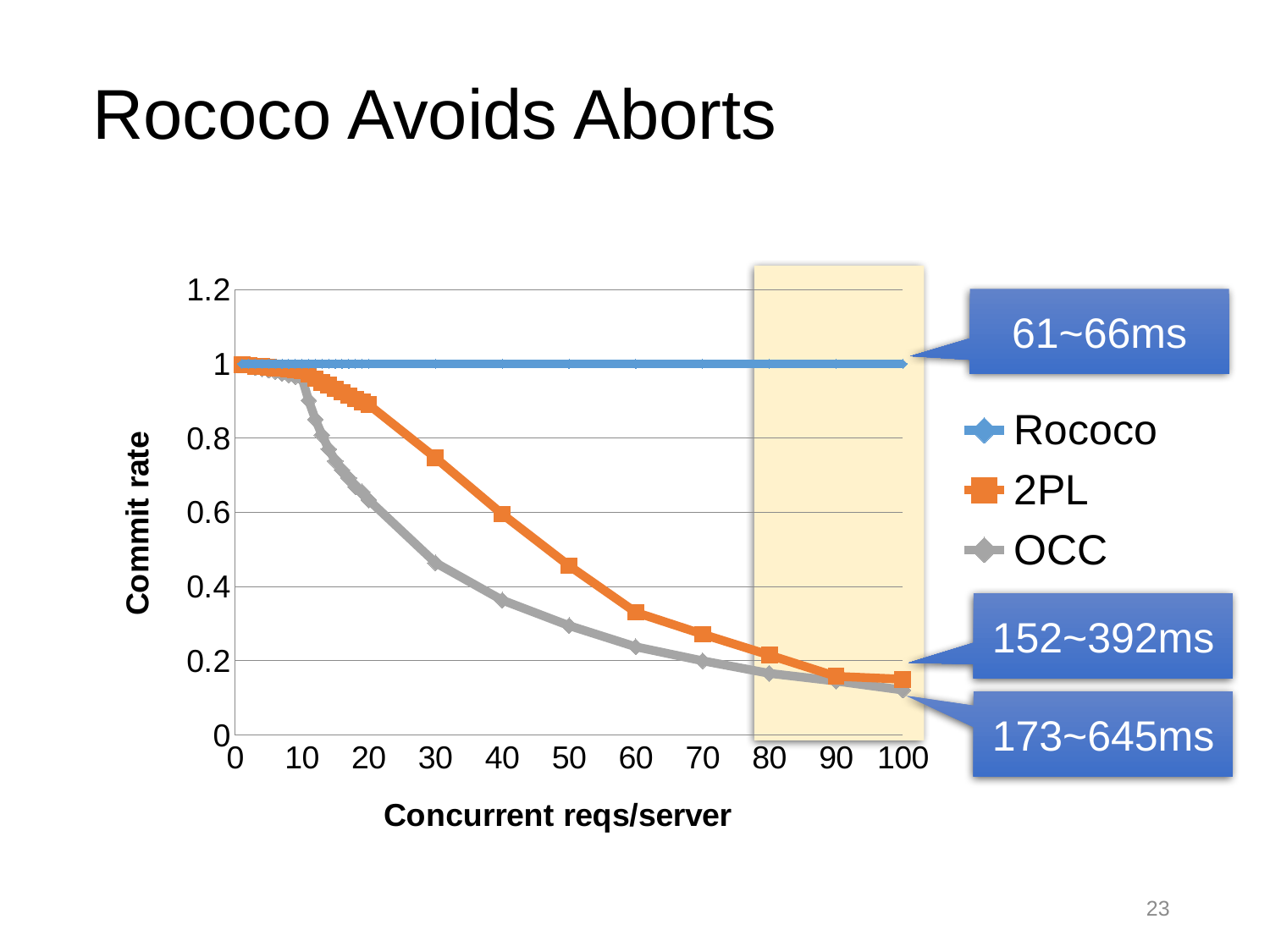
Is the commit rate for OCC at 20 concurrent reqs/server greater or less than 0.8? less Which series keeps the highest commit rate at 100 concurrent reqs/server? Rococo What is the title of the slide containing the chart? Rococo Avoids Aborts How does the commit rate for OCC change as concurrent reqs/server increases? It falls Which series has the lowest commit rate at 30 concurrent reqs/server? OCC What is the commit rate for Rococo at 100 concurrent reqs/server? 1 How many series does the legend list? 3 What kind of chart is shown on the slide? line chart Is the commit rate for 2PL at 20 concurrent reqs/server greater or less than 0.8? greater Which has the higher commit rate at 50 concurrent reqs/server, 2PL or OCC? 2PL What is the label of the y axis? Commit rate Is the commit rate for 2PL at 40 concurrent reqs/server greater or less than 0.8? less